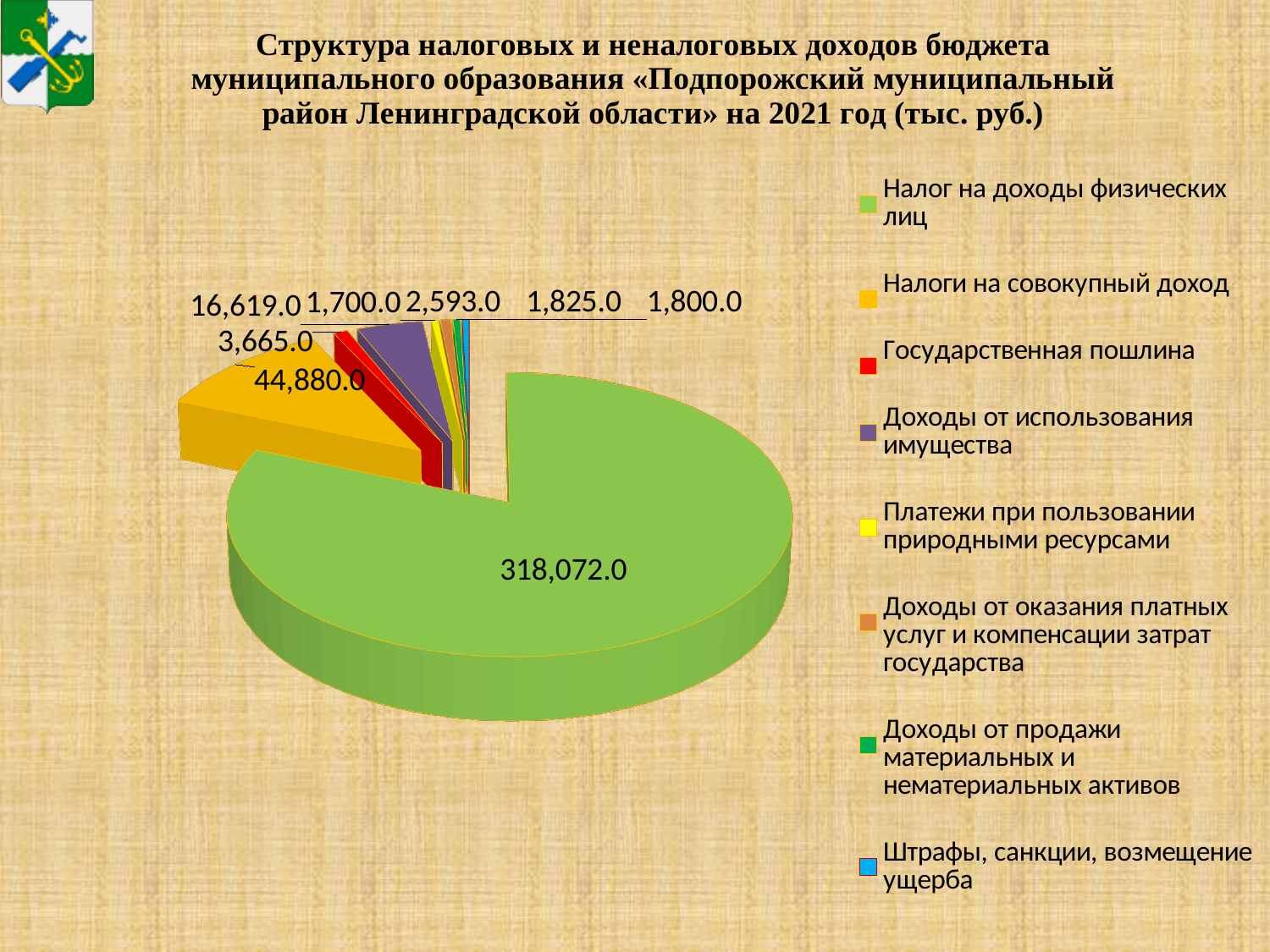
What is the value for Доходы от использования имущества? 16,619.0 What is the value for Государственная пошлина? 3,665.0 What is the value for Налоги на совокупный доход? 44,880.0 What colour is the slice for Налог на доходы физических лиц? green Which category has the largest slice of the pie? Налог на доходы физических лиц Which is larger: Государственная пошлина or Доходы от использования имущества? Доходы от использования имущества What kind of chart is shown on the slide? pie chart How many categories does the legend of the pie chart list? 8 What is the value for Налог на доходы физических лиц? 318,072.0 Which category has the smallest value? Платежи при пользовании природными ресурсами What is the difference between Налоги на совокупный доход and Доходы от использования имущества? 28,261.0 What is the value for Штрафы, санкции, возмещение ущерба? 1,800.0